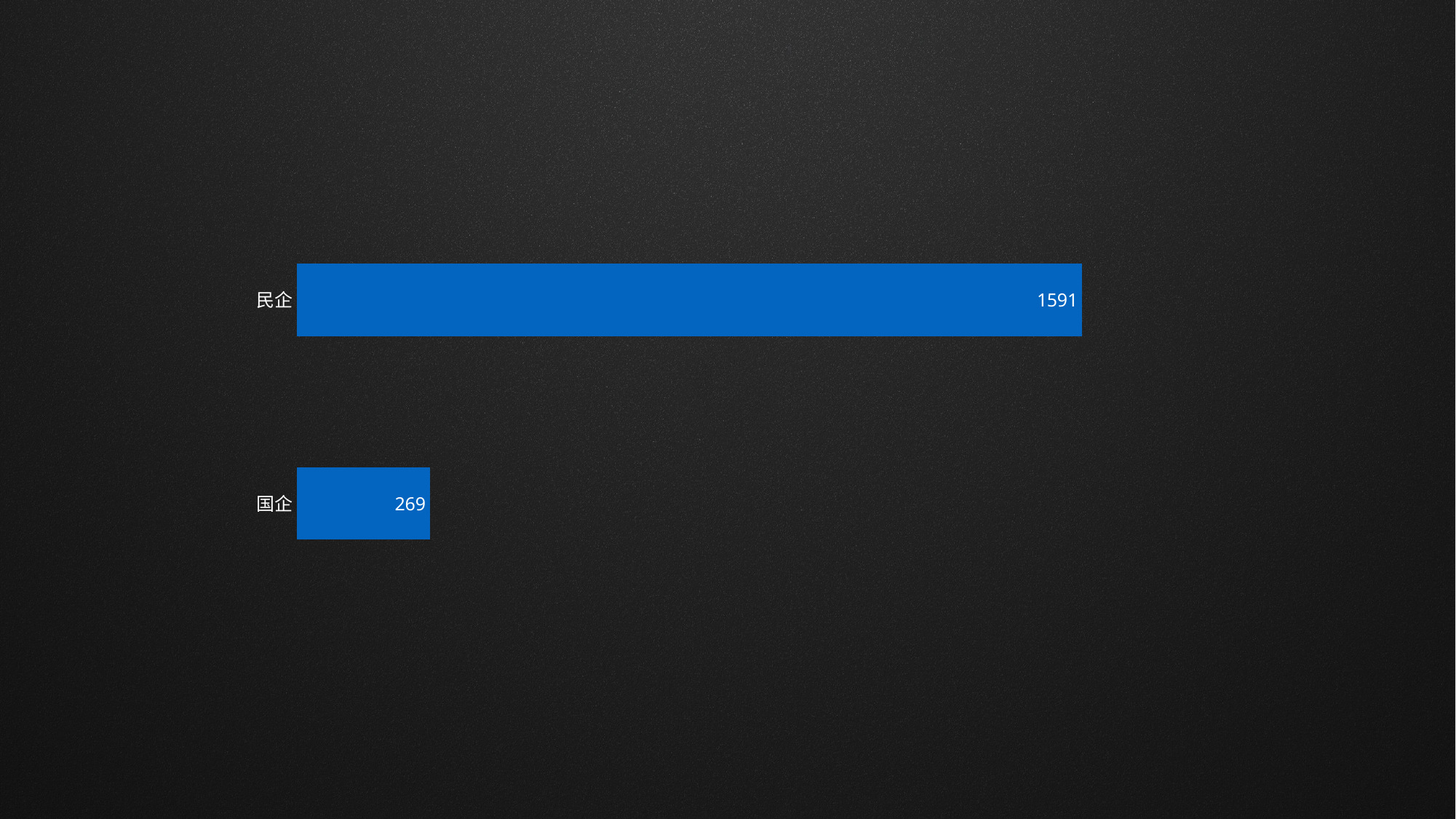
What is the total of the values for 民企 and 国企? 1860 Which is larger, the value for 民企 or the value for 国企? 民企 What is the value for 民企? 1591 Are the bars in the chart horizontal or vertical? horizontal What is the difference between the values for 民企 and 国企? 1322 Which category has the lowest value? 国企 How many categories are shown in the chart? 2 What colour are the bars in the chart? blue Which category has the highest value? 民企 What kind of chart is shown on the slide? bar chart What is the value for 国企? 269